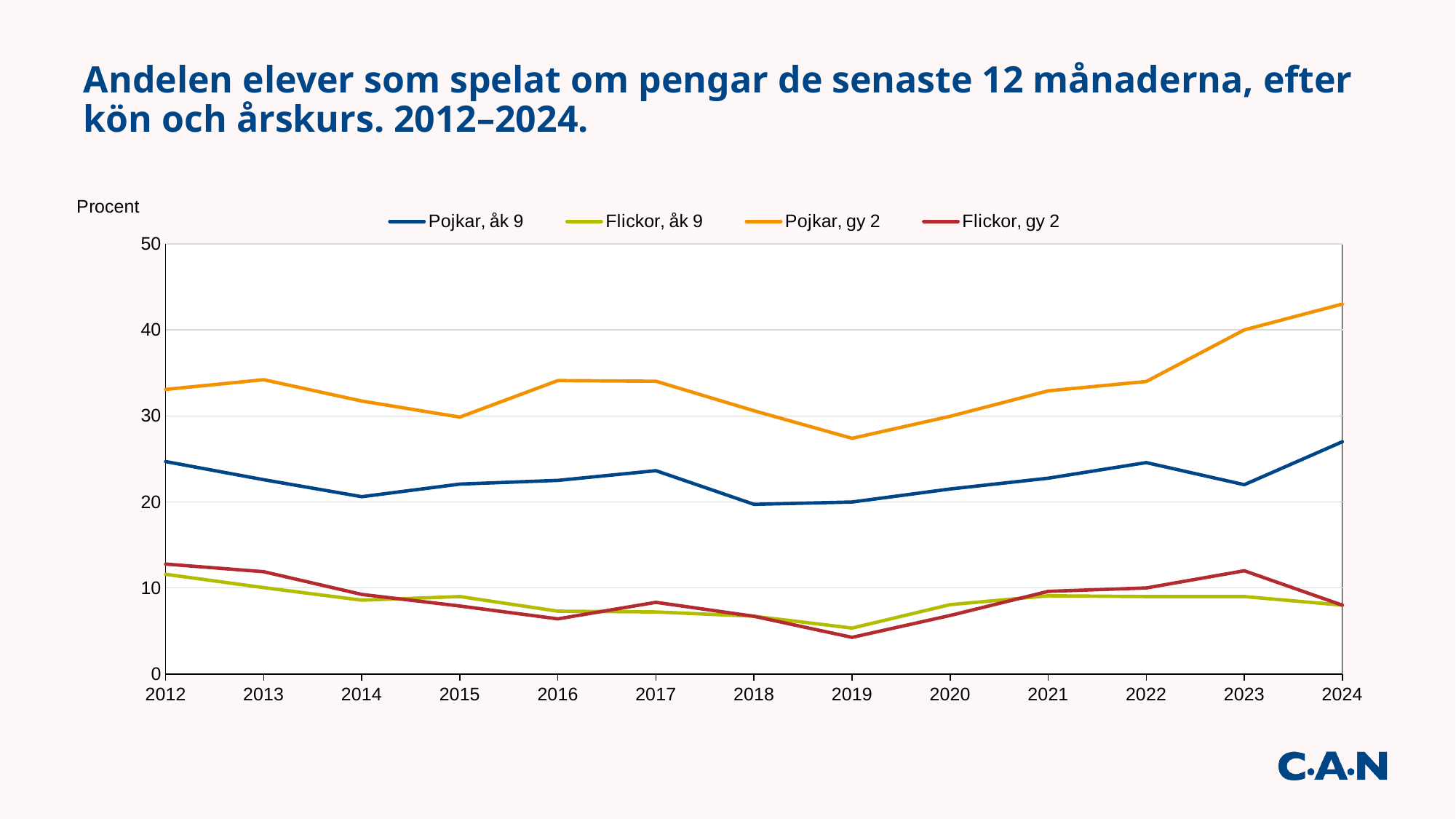
In which year does the Pojkar, gy 2 series reach its lowest value? 2019 Is the value for Pojkar, gy 2 in 2024 greater or less than 40? greater Which is larger in 2023: Flickor, gy 2 or Flickor, åk 9? Flickor, gy 2 What unit label is shown above the y axis? Procent What kind of chart is shown on the slide? line chart How many years are plotted along the x axis? 13 Which series has the highest value in 2024? Pojkar, gy 2 Is the value for Flickor, gy 2 in 2019 greater or less than 10? less How many series does the legend list? 4 In which year does the Pojkar, gy 2 series reach its highest value? 2024 Does the Pojkar, gy 2 series rise or fall from 2019 to 2024? rise In which year does the Flickor, gy 2 series reach its lowest value? 2019